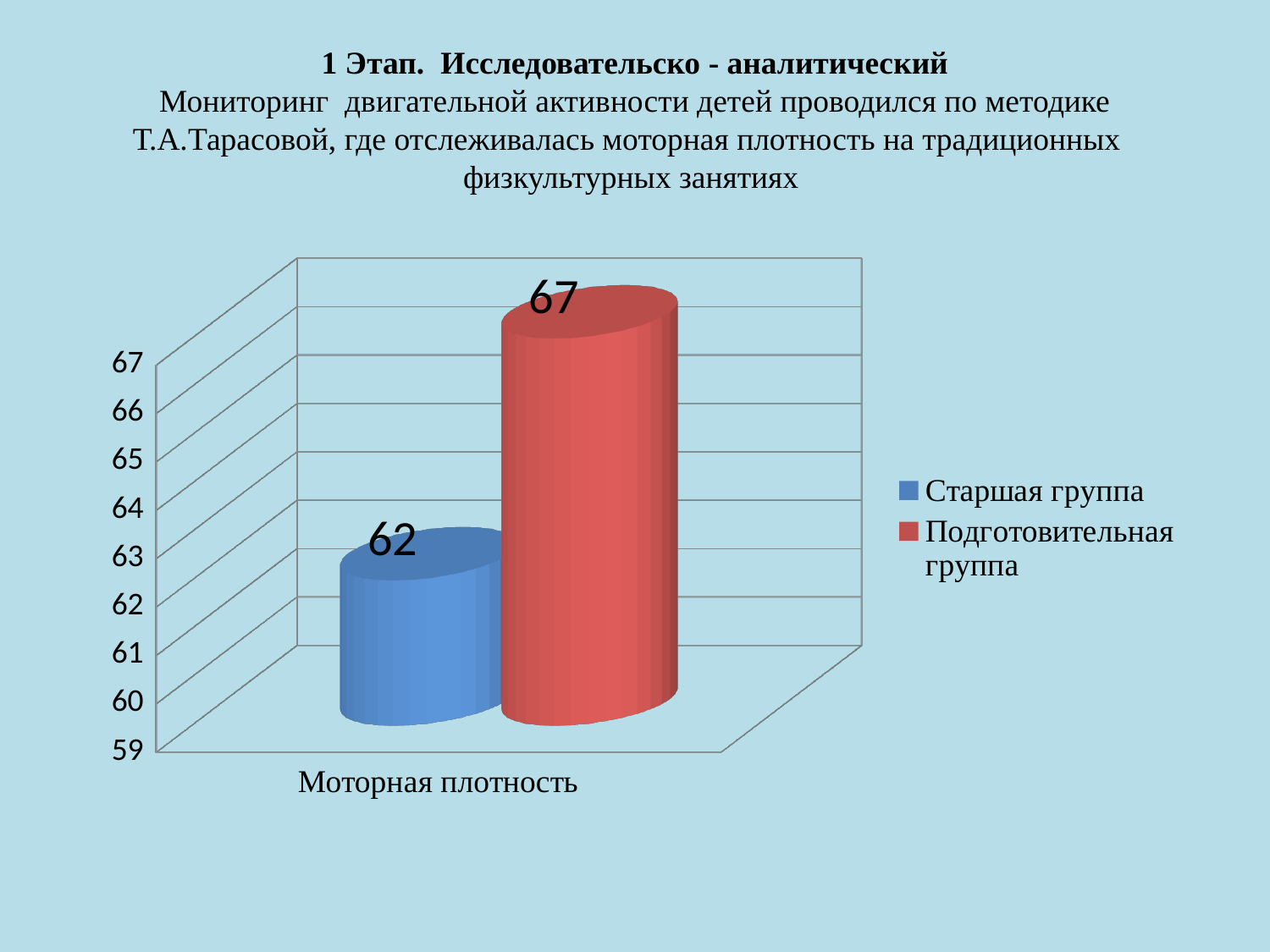
Is the value for Подготовительная группа greater or less than 65? greater Which series has the lower value for Моторная плотность? Старшая группа Is the value for Старшая группа larger or smaller than the value for Подготовительная группа? smaller Is the value for Старшая группа greater or less than 65? less What is the value for Старшая группа in the Моторная плотность chart? 62 What is the value for Подготовительная группа in the Моторная плотность chart? 67 What kind of chart is shown on the slide? bar chart How many categories are shown on the x axis? 1 How many series does the legend list? 2 Which series has the higher value for Моторная плотность? Подготовительная группа What colour is the bar for Подготовительная группа? red What is the difference between the values for Подготовительная группа and Старшая группа? 5